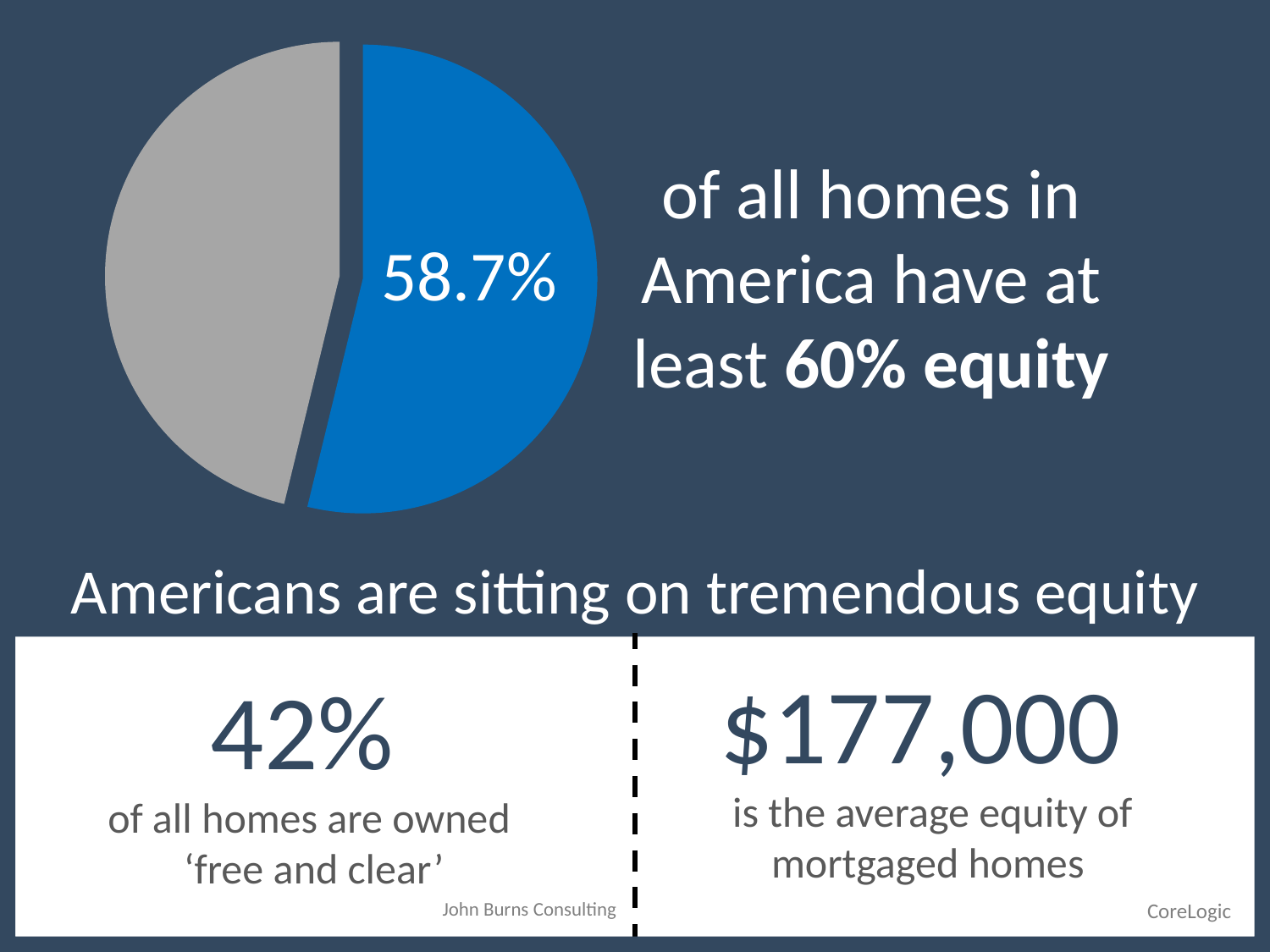
What colour is the slice of the pie chart that carries the 58.7% label? blue What value is printed on the blue slice of the pie chart? 58.7% What share of all homes in America have at least 60% equity, according to the pie chart? 58.7% What does the 58.7% slice of the pie chart represent? homes in America with at least 60% equity What kind of chart is shown on the slide? pie chart Which slice of the pie chart is the smallest? the gray slice Which slice of the pie chart is larger, the blue slice or the gray slice? the blue slice How many slices does the pie chart have? 2